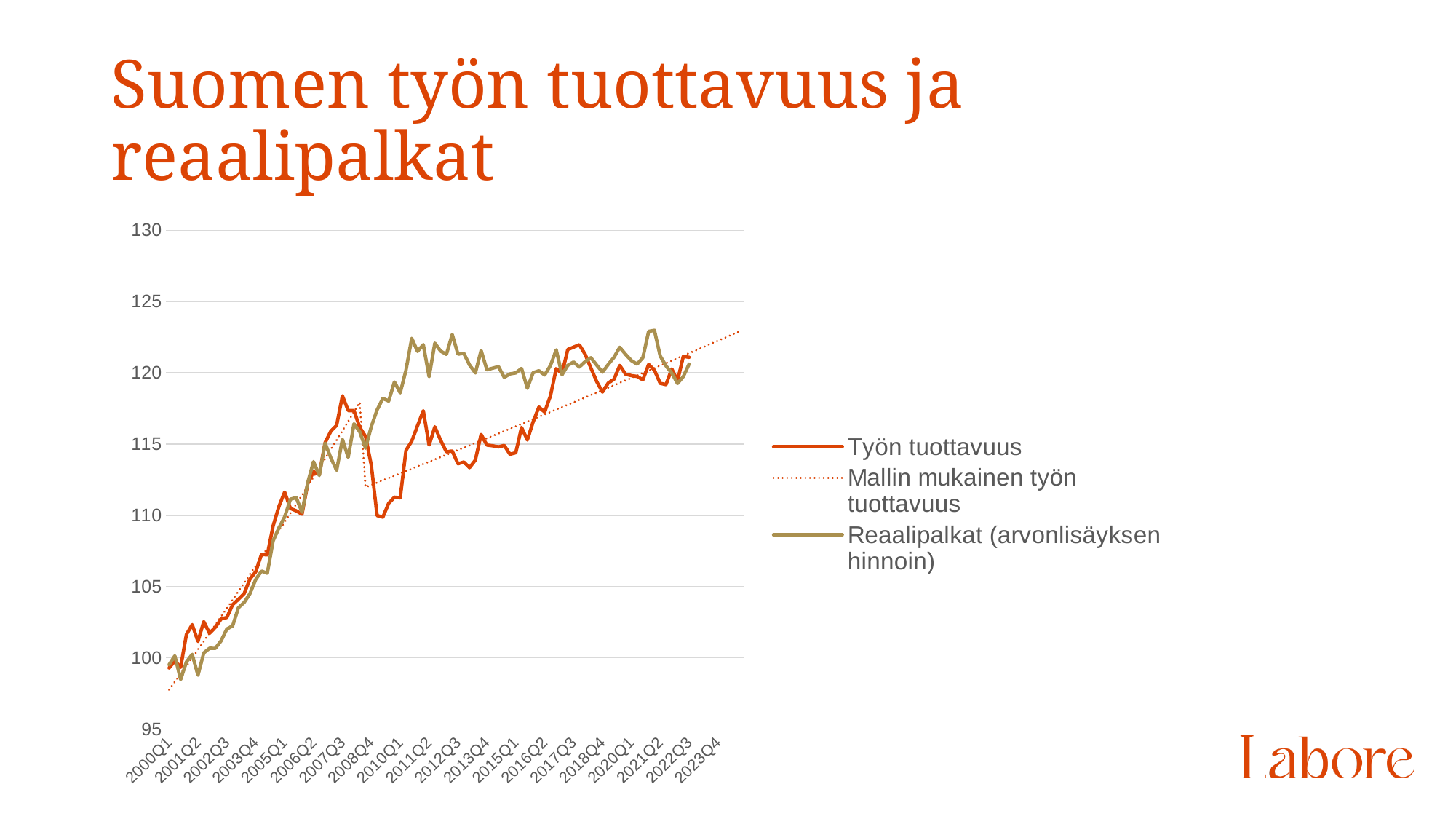
What kind of chart is shown on the slide? line chart At 2011Q2, which series is higher: Työn tuottavuus or Reaalipalkat (arvonlisäyksen hinnoin)? Reaalipalkat (arvonlisäyksen hinnoin) Is the value of Reaalipalkat (arvonlisäyksen hinnoin) at 2021Q2 greater or less than 120? greater Does the Työn tuottavuus series rise or fall overall from 2000Q1 to 2023Q4? rise How many series does the legend list? 3 Which series is drawn as a dotted line? Mallin mukainen työn tuottavuus Is the value of Työn tuottavuus at 2012Q3 greater or less than 115? less What is the title of the chart on the slide? Suomen työn tuottavuus ja reaalipalkat Is the value of Reaalipalkat (arvonlisäyksen hinnoin) at 2001Q2 greater or less than 100? less At 2010Q1, which series is higher: Työn tuottavuus or Reaalipalkat (arvonlisäyksen hinnoin)? Reaalipalkat (arvonlisäyksen hinnoin) Does the Reaalipalkat (arvonlisäyksen hinnoin) series rise or fall overall from 2000Q1 to 2011Q2? rise